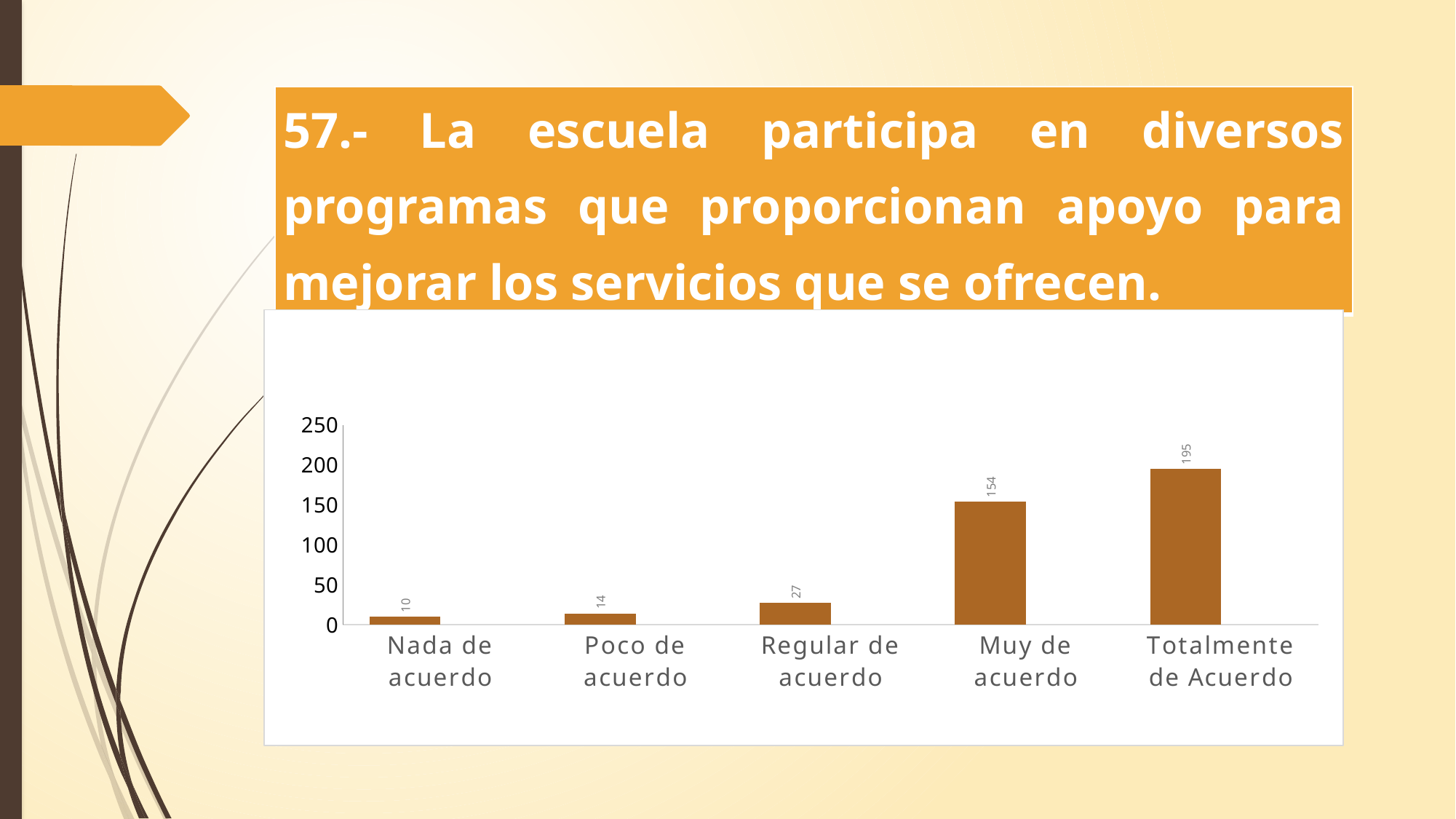
What is the value for "Nada de acuerdo"? 10 Do the values rise or fall from left to right along the x axis? rise What kind of chart is shown on the slide? bar chart What is the difference between the values for "Regular de acuerdo" and "Poco de acuerdo"? 13 Which is larger, the value for "Poco de acuerdo" or the value for "Regular de acuerdo"? Regular de acuerdo Is the value for "Muy de acuerdo" greater or less than 100? greater What is the value for "Muy de acuerdo"? 154 Which category has the lowest value? Nada de acuerdo Which category has the highest value? Totalmente de Acuerdo What is the value for "Regular de acuerdo"? 27 What is the difference between the values for "Totalmente de Acuerdo" and "Muy de acuerdo"? 41 How many categories are shown on the x axis? 5